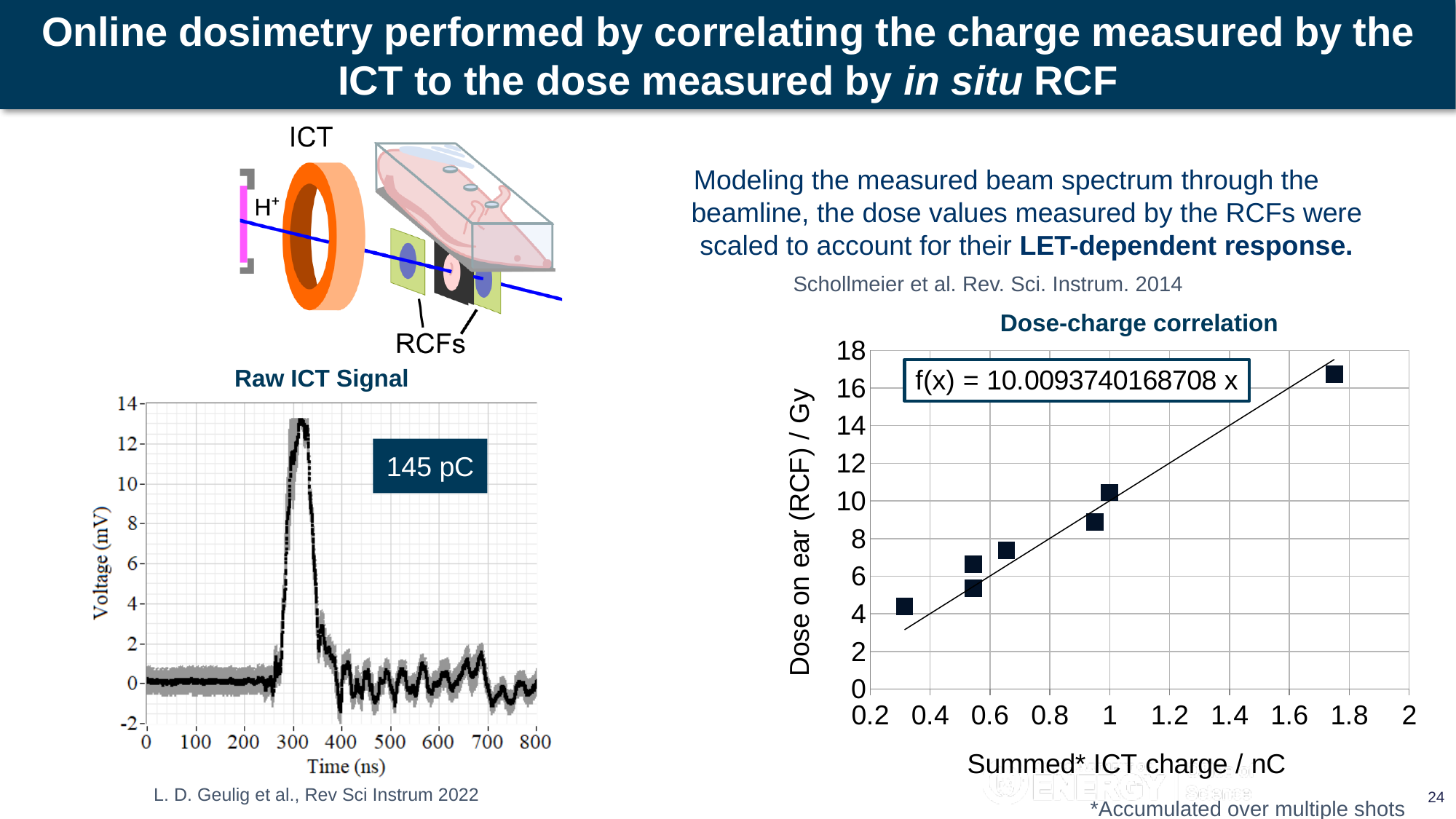
What charge value is annotated on the Raw ICT Signal chart? 145 pC What kind of chart is the Dose-charge correlation chart? Scatter plot In the Dose-charge correlation chart, what is the equation of the fitted line? f(x) = 10.0093740168708 x In the Dose-charge correlation chart, is the dose of the point with the largest ICT charge greater or less than 16 Gy? greater What is the y-axis label of the Dose-charge correlation chart? Dose on ear (RCF) / Gy In the Dose-charge correlation chart, does the dose rise or fall as the summed ICT charge increases? Rises In the Dose-charge correlation chart, is the dose of the point with the smallest ICT charge greater or less than 6 Gy? less What is the x-axis label of the Dose-charge correlation chart? Summed* ICT charge / nC In the Raw ICT Signal chart, is the peak voltage greater or less than 12 mV? greater How many data points are plotted in the Dose-charge correlation chart? 7 What kind of chart is the Raw ICT Signal chart? Line chart